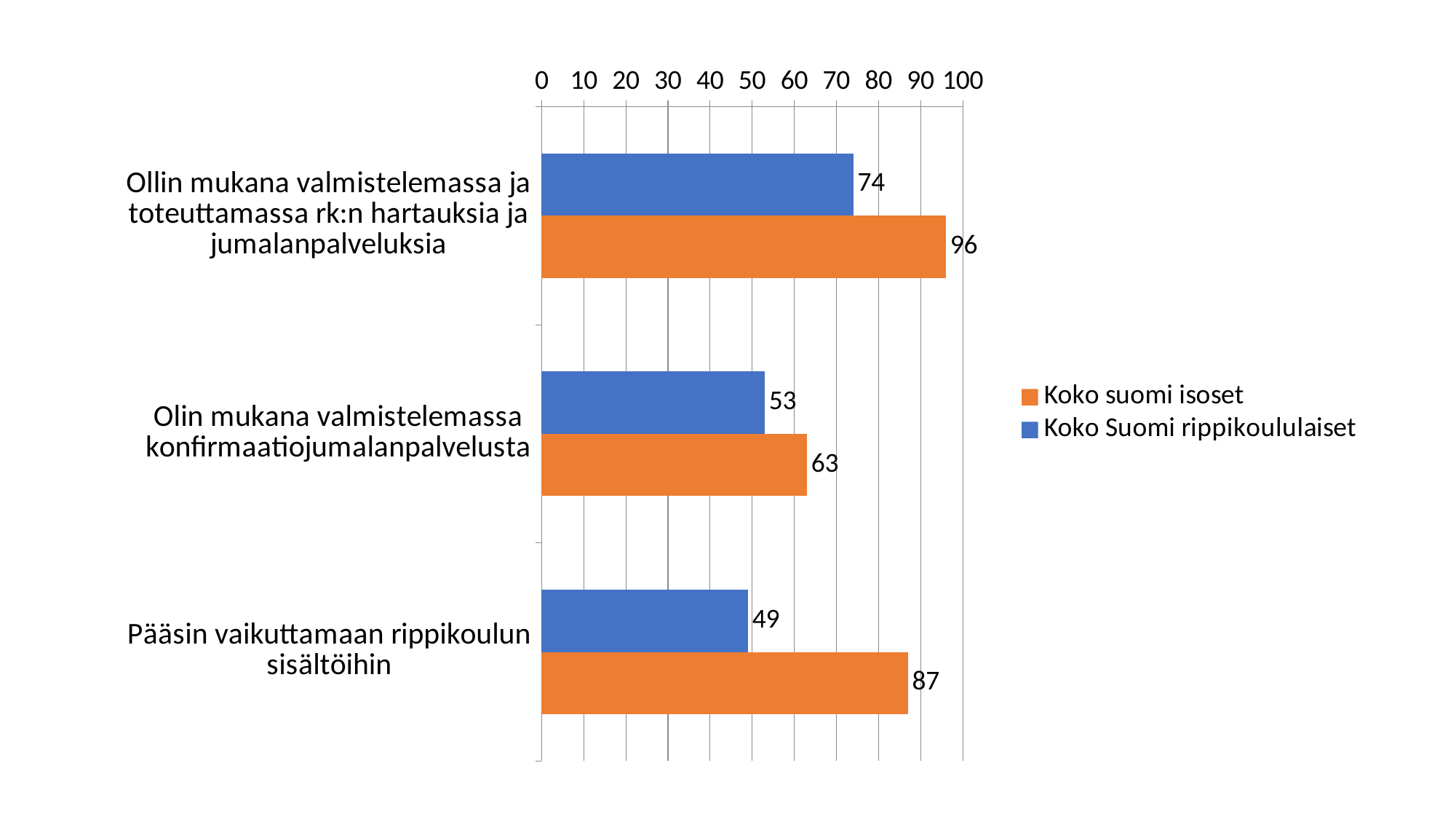
How many series does the legend list? 2 In the category "Olin mukana valmistelemassa konfirmaatiojumalanpalvelusta", which series has the larger value? Koko suomi isoset How many categories are shown on the chart? 3 Which category has the highest value for "Koko Suomi rippikoululaiset"? Ollin mukana valmistelemassa ja toteuttamassa rk:n hartauksia ja jumalanpalveluksia Which category has the lowest value for "Koko suomi isoset"? Olin mukana valmistelemassa konfirmaatiojumalanpalvelusta What is the difference between "Koko suomi isoset" and "Koko Suomi rippikoululaiset" in the category "Pääsin vaikuttamaan rippikoulun sisältöihin"? 38 What is the value for "Koko suomi isoset" in the category "Pääsin vaikuttamaan rippikoulun sisältöihin"? 87 What is the value for "Koko suomi isoset" in the category "Ollin mukana valmistelemassa ja toteuttamassa rk:n hartauksia ja jumalanpalveluksia"? 96 What kind of chart is shown on the slide? Bar chart Is the value for "Koko Suomi rippikoululaiset" in "Pääsin vaikuttamaan rippikoulun sisältöihin" greater or less than 50? less What is the value for "Koko Suomi rippikoululaiset" in the category "Olin mukana valmistelemassa konfirmaatiojumalanpalvelusta"? 53 Which colour represents "Koko Suomi rippikoululaiset" in the chart? Blue